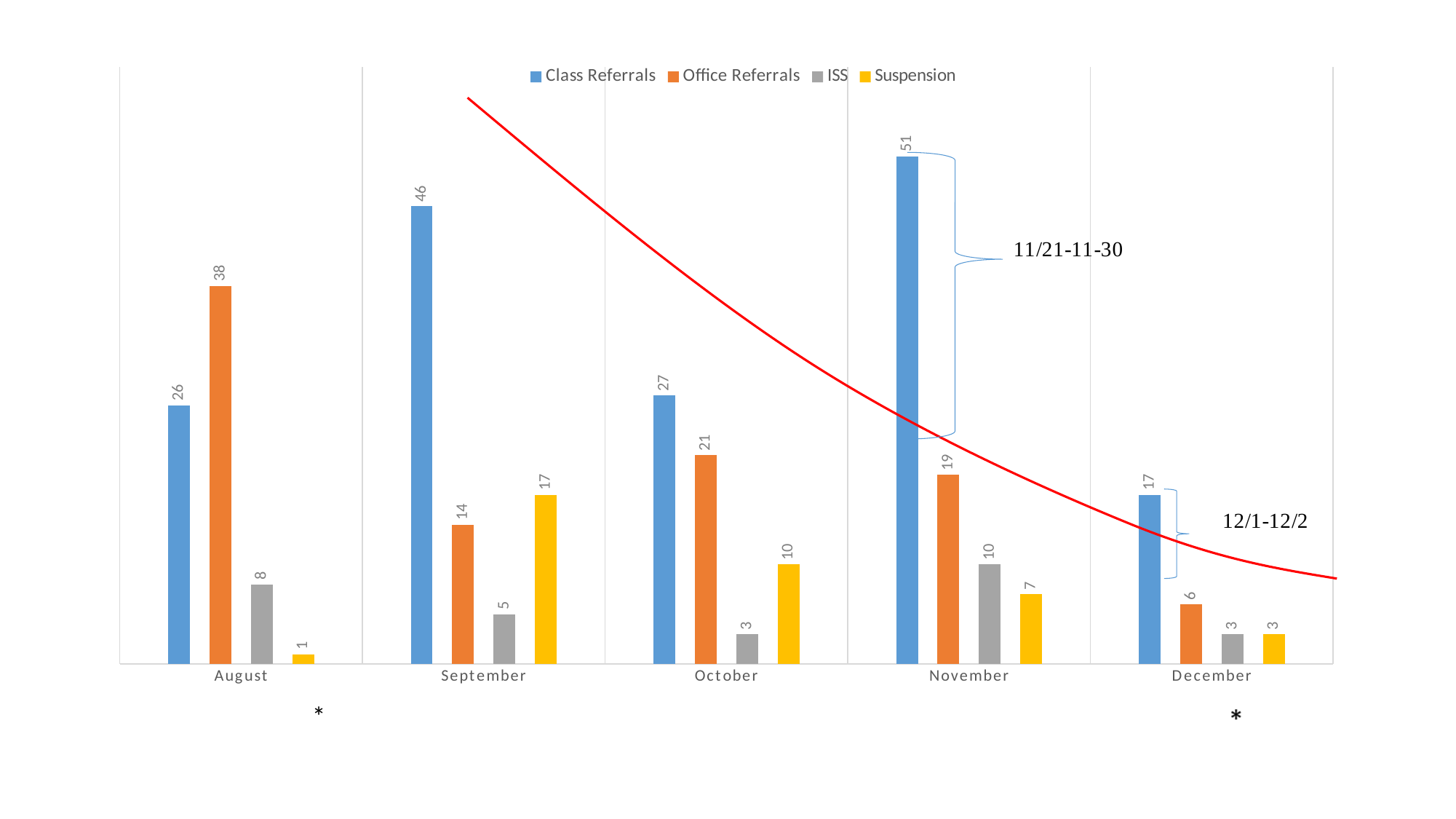
Which is larger in August: Class Referrals or Office Referrals? Office Referrals Which month has the lowest value for Suspension? August What is the value of Suspension for September? 17 Which colour represents ISS in the legend? Gray What is the difference between Class Referrals and Office Referrals in September? 32 What is the value of Office Referrals for August? 38 What is the value of ISS for December? 3 How many months are shown on the x axis? 5 What kind of chart is shown on the slide? Bar chart What is the value of Class Referrals for November? 51 How many series does the legend list? 4 Which month has the highest value for Class Referrals? November